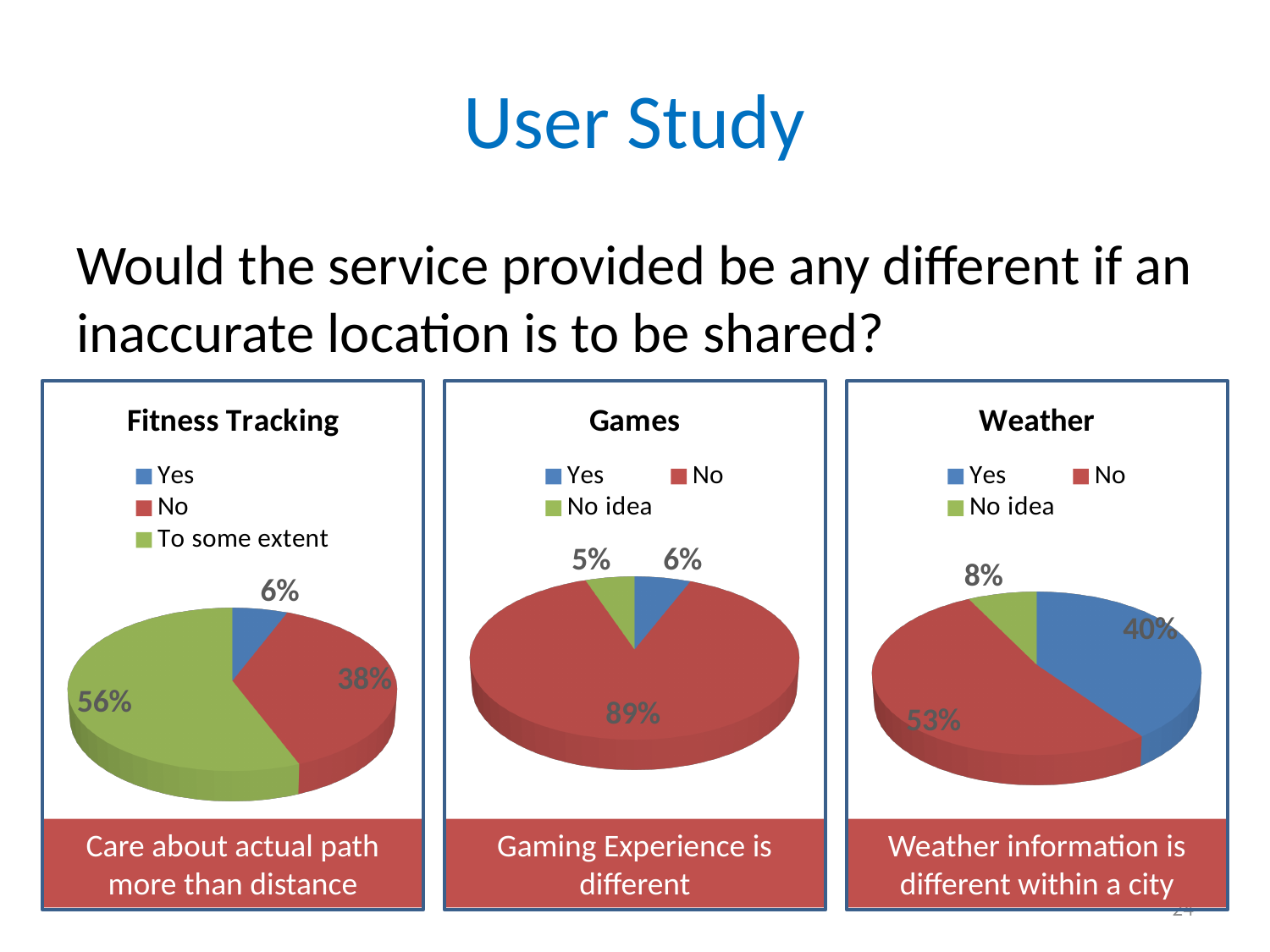
In the Weather chart, which is larger, the "Yes" share or the "No idea" share? Yes In the Fitness Tracking chart, what is the difference between the "To some extent" share and the "No" share? 18% What kind of chart is the Weather chart? Pie chart How many slices does the Games chart have? 3 In the Fitness Tracking chart, what percentage answered "To some extent"? 56% How many entries does the legend of the Fitness Tracking chart list? 3 In the Weather chart, which response has the largest share? No In the Fitness Tracking chart, which colour represents "To some extent"? Green In the Weather chart, what percentage answered "Yes"? 40% In the Games chart, what percentage answered "No"? 89% In the Games chart, which response has the smallest share? No idea In the Fitness Tracking chart, what percentage answered "No"? 38%